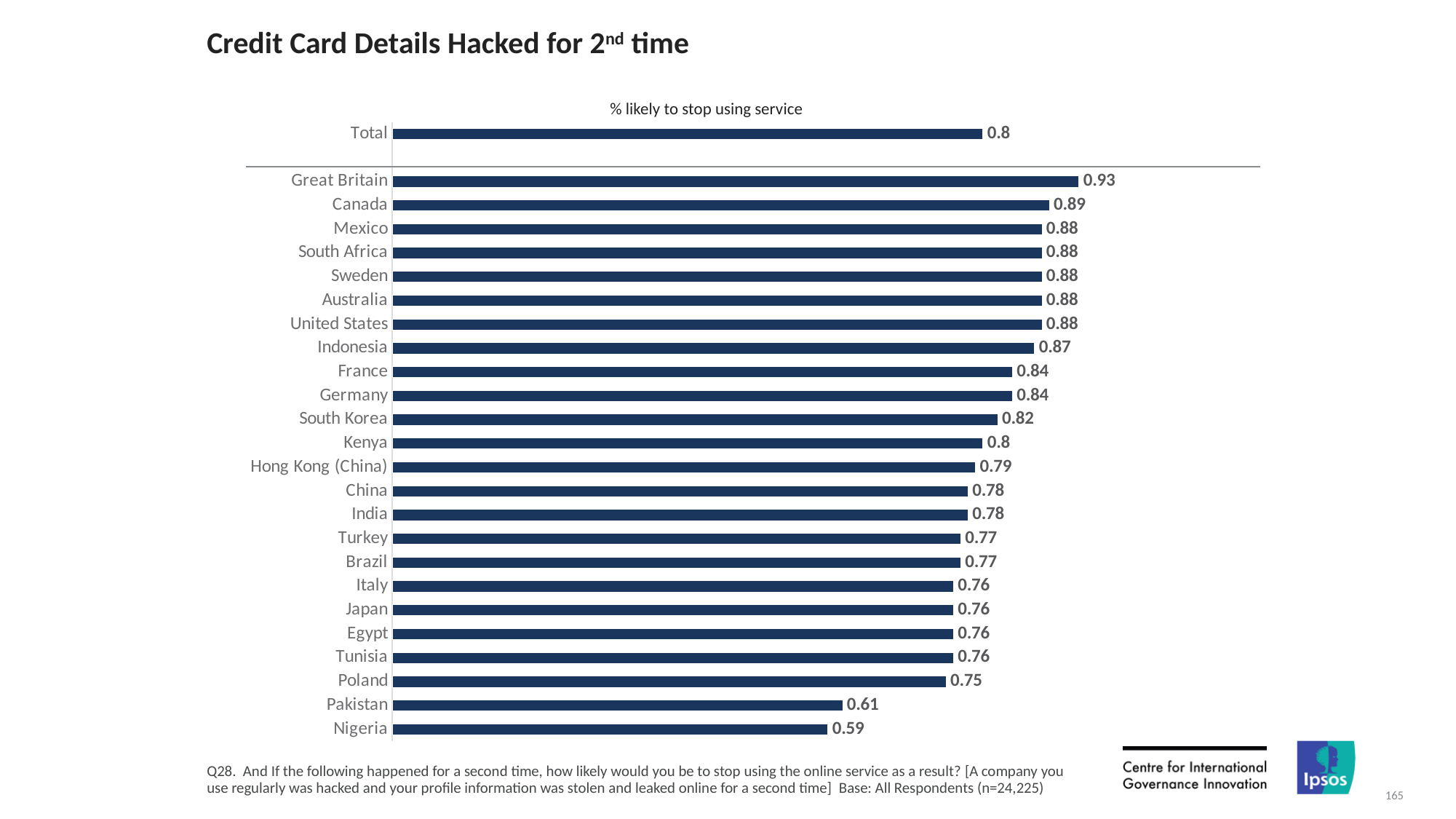
What kind of chart is shown on the slide? Bar chart What is the value for Indonesia? 0.87 Which has a larger value, South Korea or Poland? South Korea Which country has the lowest value? Nigeria What is the title of the chart? % likely to stop using service What is the difference between the values for Great Britain and Nigeria? 0.34 What is the value for Great Britain? 0.93 What is the difference between the values for Canada and Pakistan? 0.28 What is the value for Nigeria? 0.59 How many countries are listed below the Total bar? 24 Which country has the highest value? Great Britain What is the value for Total? 0.8